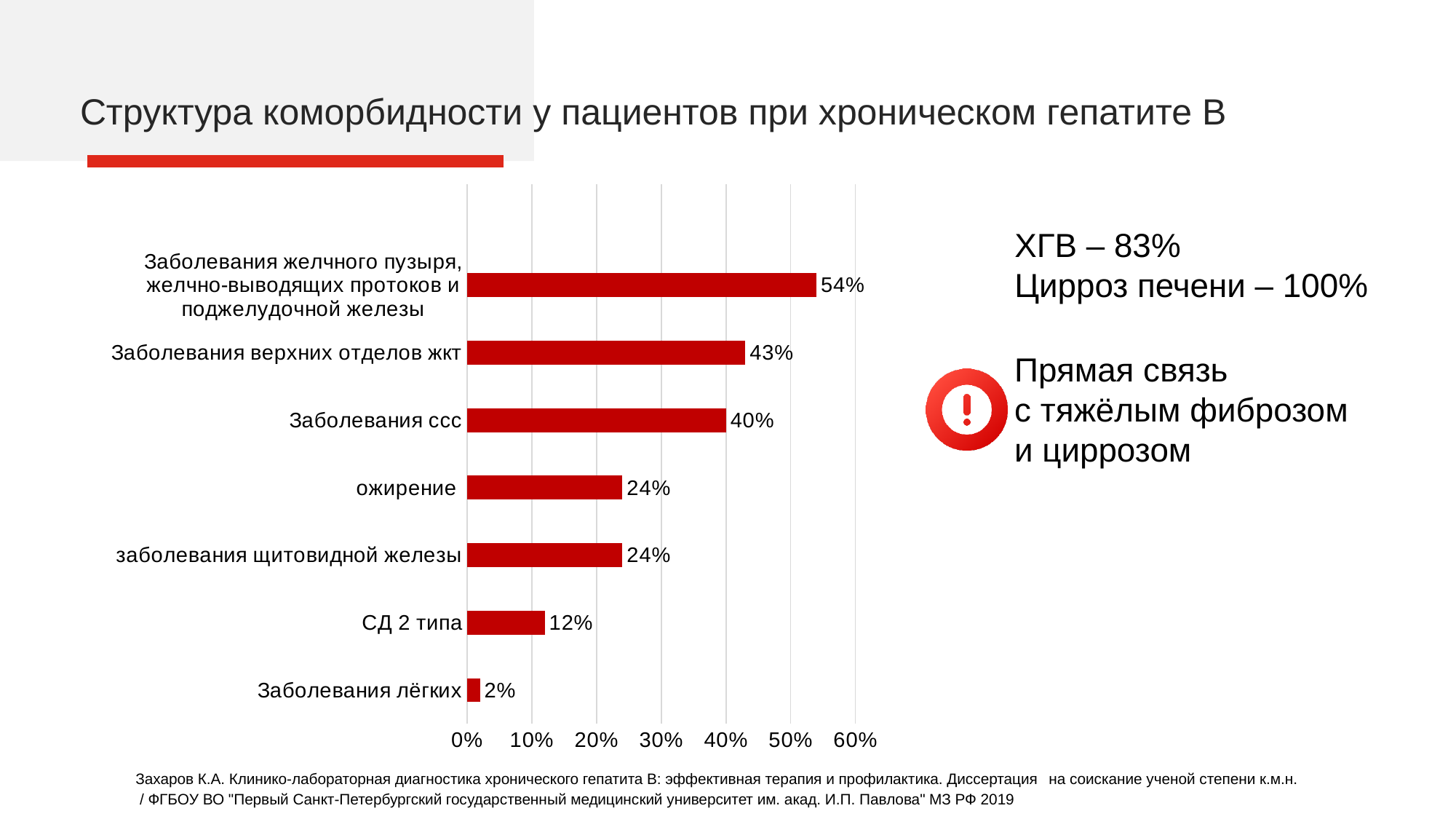
What is the difference between the values for ожирение and СД 2 типа? 12% How many categories are shown in the chart? 7 What is the value for СД 2 типа? 12% Which is larger, the value for Заболевания ссс or the value for заболевания щитовидной железы? Заболевания ссс Which category has the highest value? Заболевания желчного пузыря, желчно-выводящих протоков и поджелудочной железы What is the value for Заболевания верхних отделов жкт? 43% What is the value for ожирение? 24% What kind of chart is shown on the slide? bar chart Which category has the lowest value? Заболевания лёгких What is the difference between the values for Заболевания верхних отделов жкт and Заболевания ссс? 3% What is the value for Заболевания ссс? 40% Is the value for Заболевания желчного пузыря, желчно-выводящих протоков и поджелудочной железы greater or less than 50%? greater